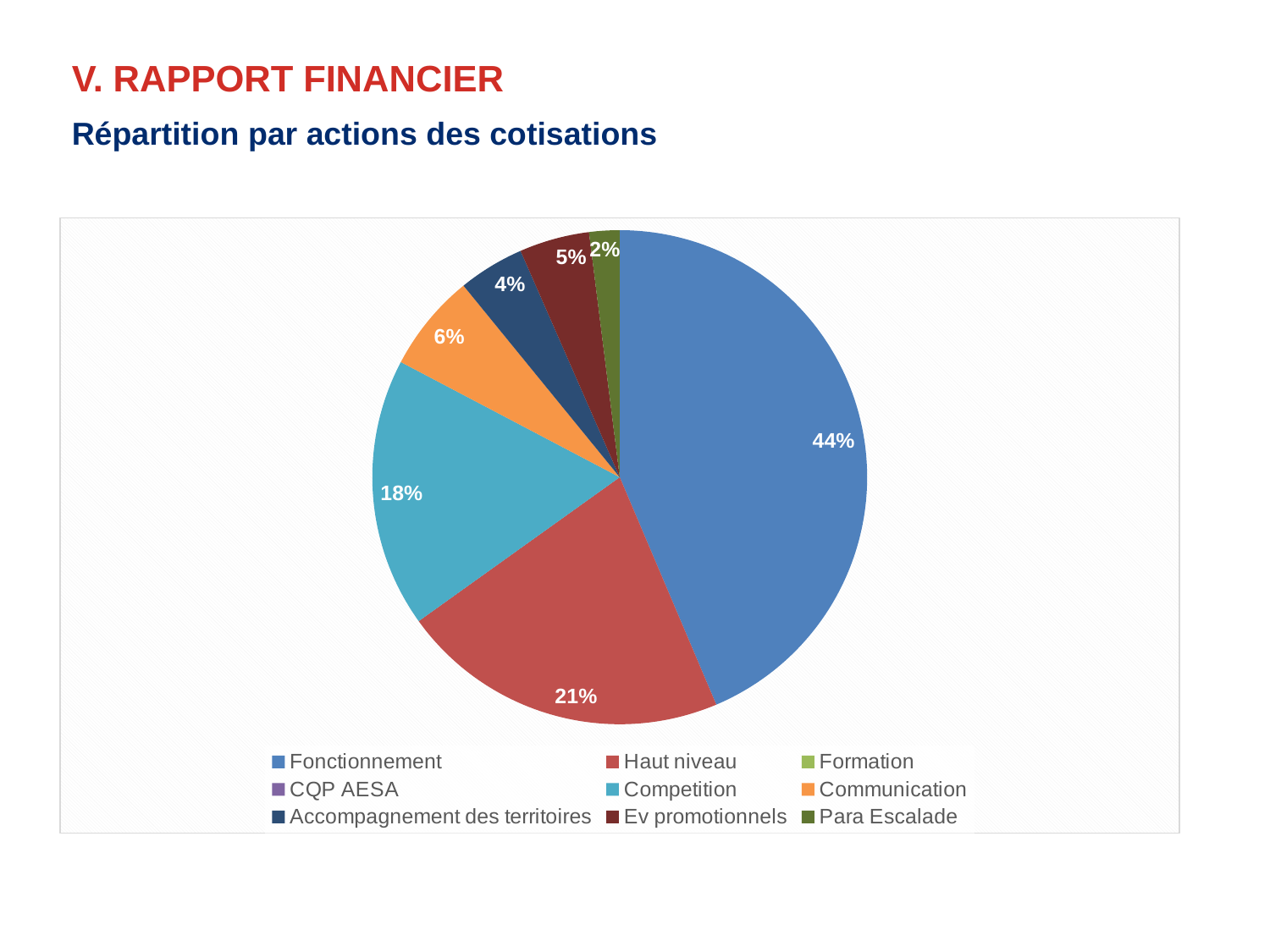
Which labelled slice has the smallest share of the pie? Para Escalade What percentage is shown for Communication? 6% What percentage is shown for Competition? 18% Which has a larger share, Competition or Communication? Competition What kind of chart is shown on the slide? Pie chart How many entries does the legend list? 9 What percentage is shown for Ev promotionnels? 5% What percentage is shown for Para Escalade? 2% What share of the pie does Fonctionnement represent? 44% What is the difference in percentage points between Fonctionnement and Haut niveau? 23 What percentage is shown for Haut niveau? 21% Which category has the largest share of the pie? Fonctionnement